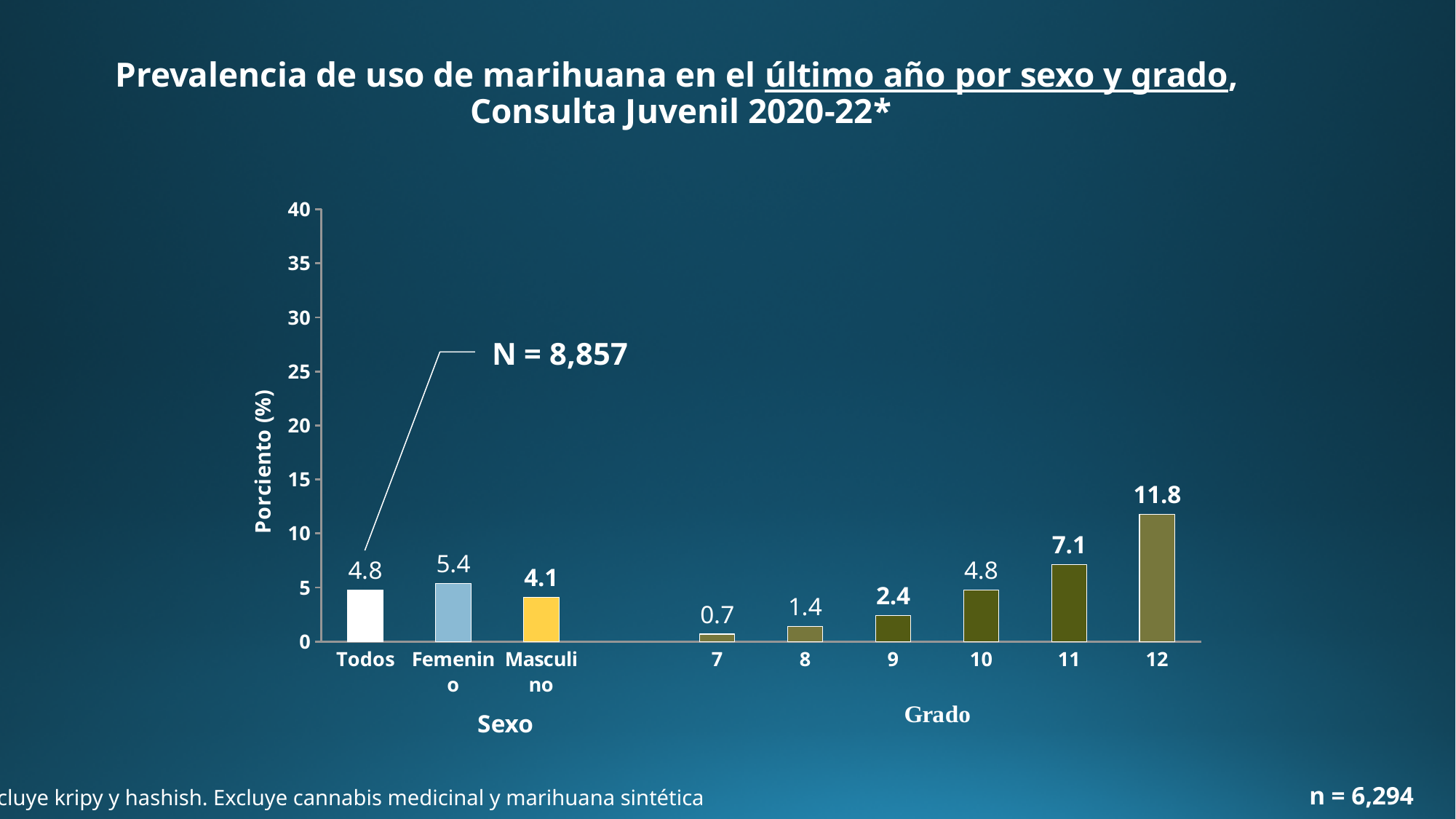
Which grade has the lowest value? 7 What is the difference between the values for grade 12 and grade 11? 4.7 What is the value for Todos? 4.8 Is the value for grade 12 greater or less than 10? greater What is the value for grade 7? 0.7 What is the value for Masculino? 4.1 What is the value for grade 12? 11.8 Do the values rise or fall from grade 7 to grade 12? rise What kind of chart is shown on the slide? bar chart Which is larger, the value for Femenino or the value for Masculino? Femenino What is the value for Femenino? 5.4 Which grade has the highest value? 12